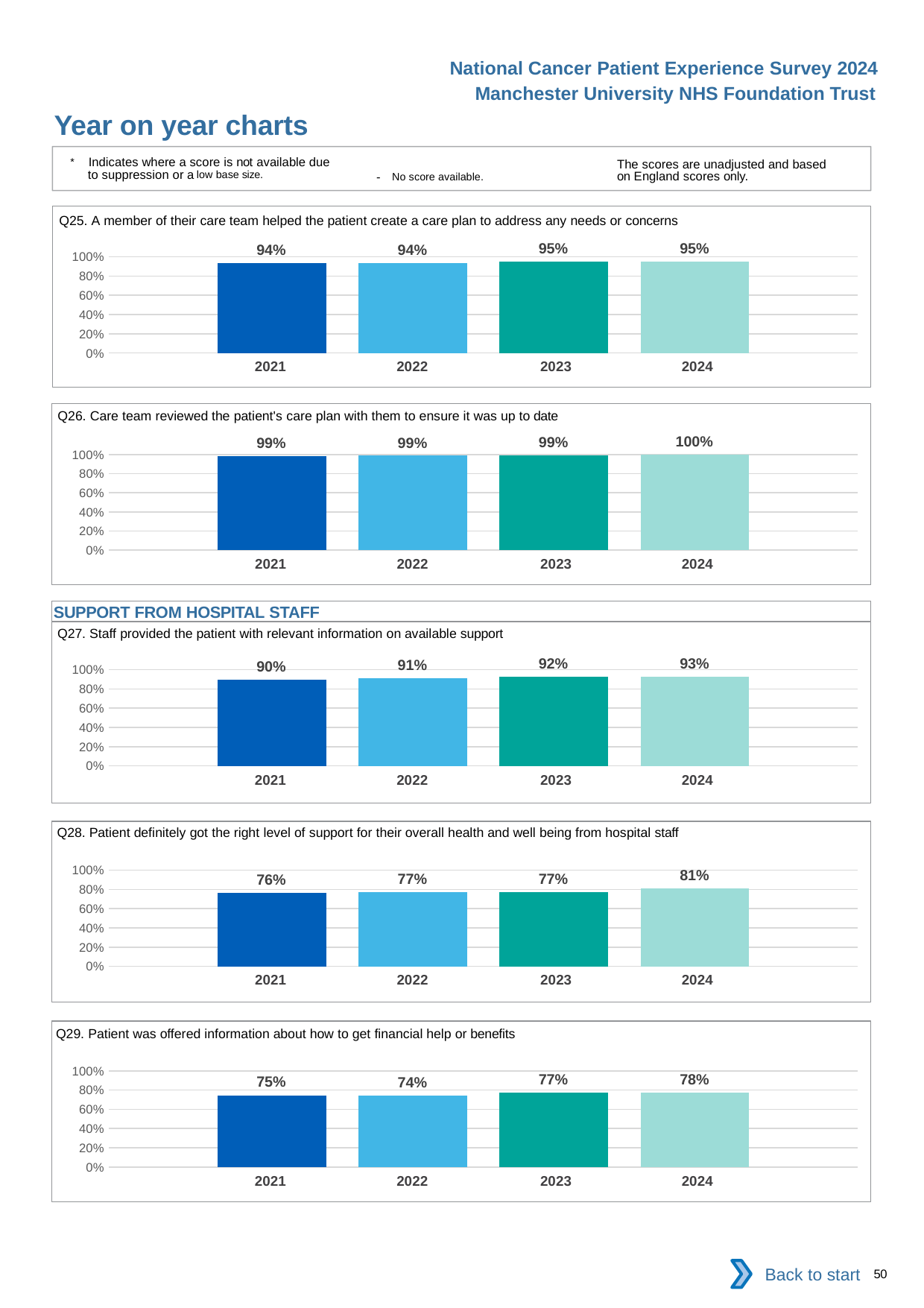
In the Q27 chart (relevant information on available support), what is the difference between the 2024 and 2021 values? 3 percentage points In the Q28 chart (right level of support from hospital staff), which year has the lowest value? 2021 In the Q29 chart (information about financial help or benefits), what is the value for 2022? 74% How many years are shown on the x axis of the Q25 chart? 4 In the Q28 chart (right level of support from hospital staff), what is the difference between the 2024 and 2023 values? 4 percentage points What is the section heading shown above the Q27 chart? SUPPORT FROM HOSPITAL STAFF In the Q27 chart (relevant information on available support), do the values rise or fall from 2021 to 2024? Rise What kind of chart is the Q27 chart (relevant information on available support)? Bar chart In the Q29 chart (information about financial help or benefits), which is larger, the value for 2021 or 2022? 2021 In the Q25 chart (care plan to address needs or concerns), what is the value for 2023? 95% In the Q26 chart (care team reviewed the care plan), which year has the highest value? 2024 In the Q28 chart (right level of support from hospital staff), is the value for 2021 greater or less than 80%? less